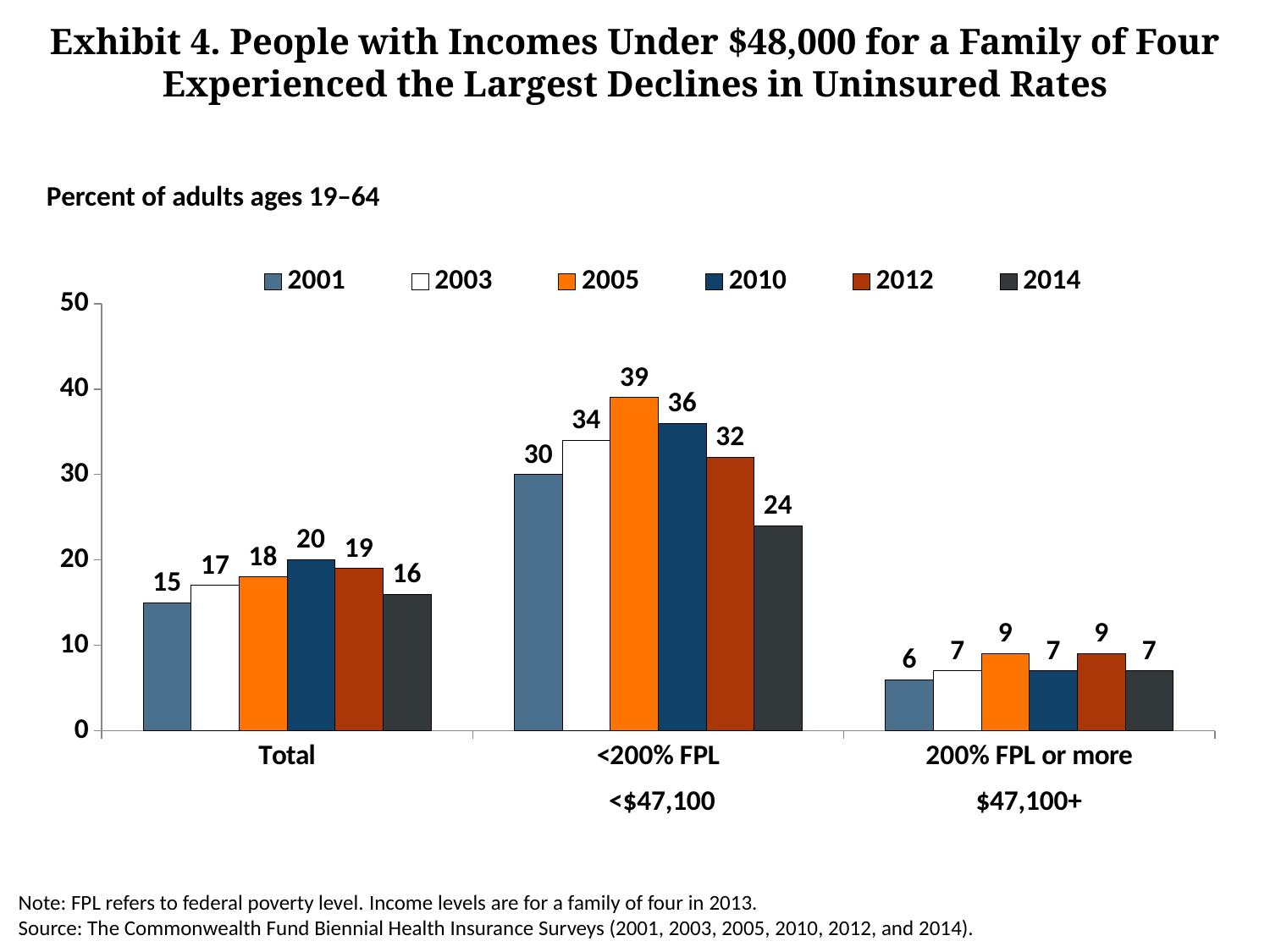
What kind of chart is shown on the slide? bar chart How many series does the legend list? 6 Is the 2003 value for <200% FPL greater or less than 30? greater What is the value for 2001 in the Total category? 15 Which year has the highest value in the <200% FPL category? 2005 How many categories are shown on the x axis? 3 What is the value for 2005 in the 200% FPL or more category? 9 What is the difference between the 2005 and 2014 values in the <200% FPL category? 15 What is the value for 2014 in the <200% FPL category? 24 Which is larger: the 2010 value for Total or the 2012 value for Total? 2010 Which year has the lowest value in the Total category? 2001 What is the y-axis label shown above the chart? Percent of adults ages 19–64